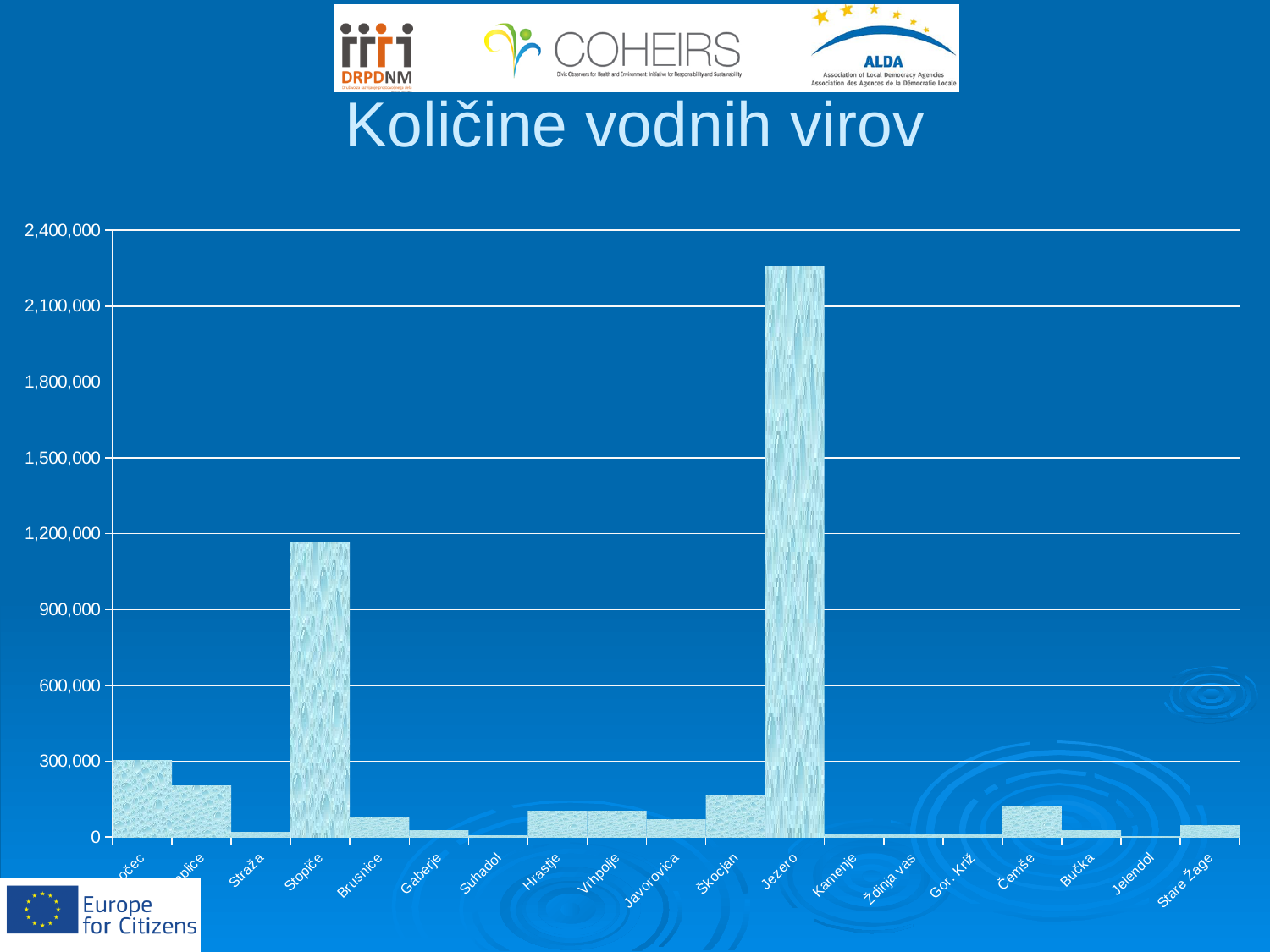
What is the title of the chart? Količine vodnih virov Is the value for Stopiče greater or less than 1,200,000? less Which has a larger value, Jezero or Stopiče? Jezero How many bars are plotted in the chart? 19 What is the highest value shown on the vertical axis? 2,400,000 What kind of chart is shown on the slide? bar chart Is the value for Čemše greater or less than 300,000? less Is the value for Stopiče greater or less than 900,000? greater Which has a larger value, Stopiče or Škocjan? Stopiče Which category has the highest value? Jezero